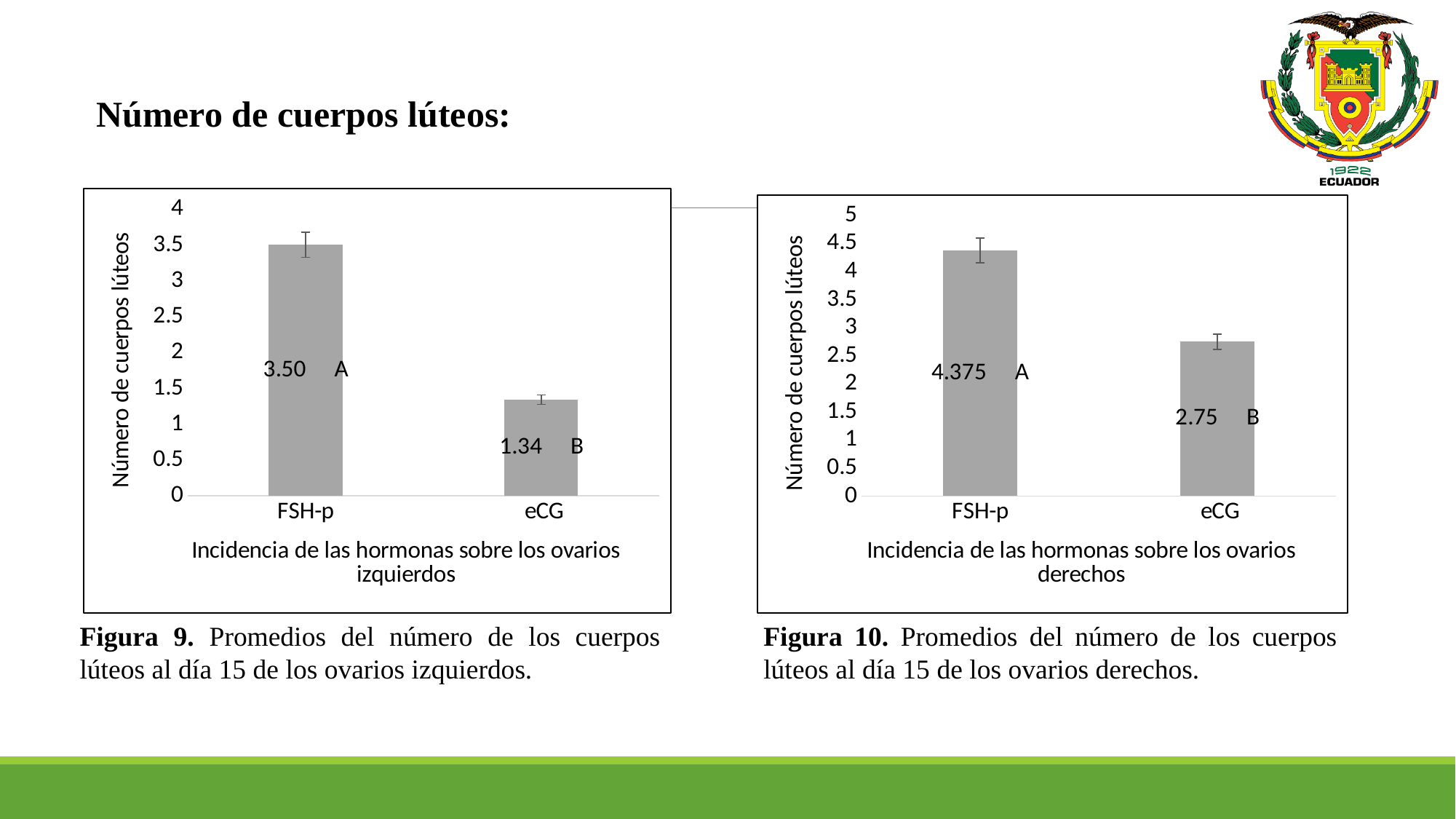
In the left chart (ovarios izquierdos), what is the difference between the FSH-p and eCG values? 2.16 In the left chart (ovarios izquierdos), which category has the highest value? FSH-p What kind of chart is the right chart (ovarios derechos)? bar chart What is the y-axis label of the left chart (ovarios izquierdos)? Número de cuerpos lúteos In the right chart (ovarios derechos), what is the difference between the FSH-p and eCG values? 1.625 In the right chart (ovarios derechos), is the value for eCG greater or less than 3? less In the right chart (ovarios derechos), what is the value for eCG? 2.75 How many categories are shown in the left chart (ovarios izquierdos)? 2 In the left chart (ovarios izquierdos), what is the value for FSH-p? 3.50 In the right chart (ovarios derechos), what is the value for FSH-p? 4.375 In the left chart (ovarios izquierdos), what is the value for eCG? 1.34 In the right chart (ovarios derechos), which category has the lowest value? eCG